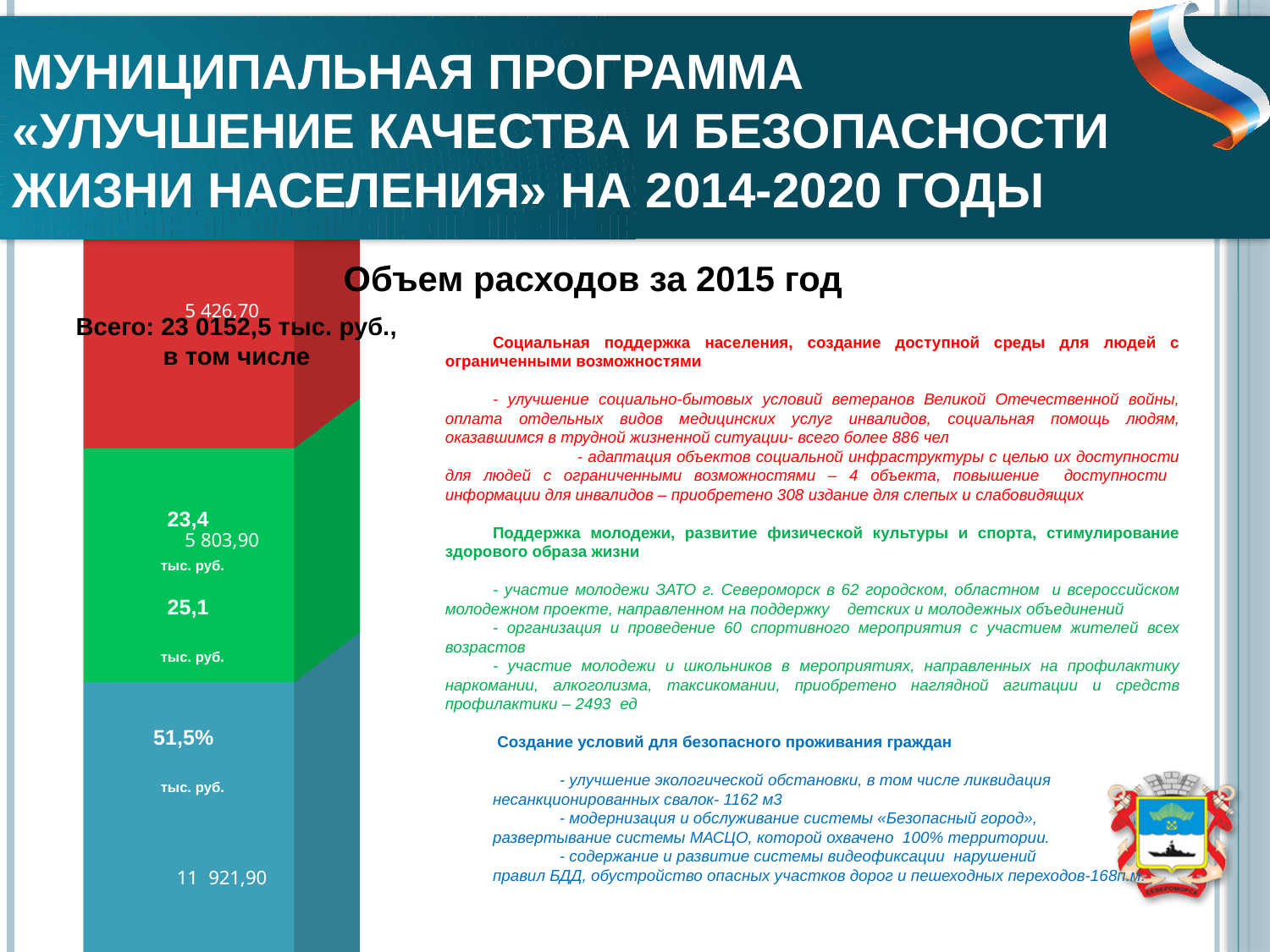
What value is labelled on the bottom (blue) segment of the bar? 11 921,90 What is the title of the chart? Объем расходов за 2015 год How many segments make up the stacked bar? 3 What value is labelled on the middle (green) segment of the bar? 5 803,90 Which segment of the bar has the largest value? The bottom (blue) segment, 11 921,90 What is the difference between the middle (green) segment and the top (red) segment? 377,20 Which is larger, the top (red) segment or the middle (green) segment? The middle (green) segment What is the difference between the bottom (blue) segment and the middle (green) segment? 6 118,00 Which segment of the bar has the smallest value? The top (red) segment, 5 426,70 What percentage share is shown for the bottom (blue) segment? 51,5% What value is labelled on the top (red) segment of the bar? 5 426,70 What kind of chart is shown on the slide? Stacked bar chart